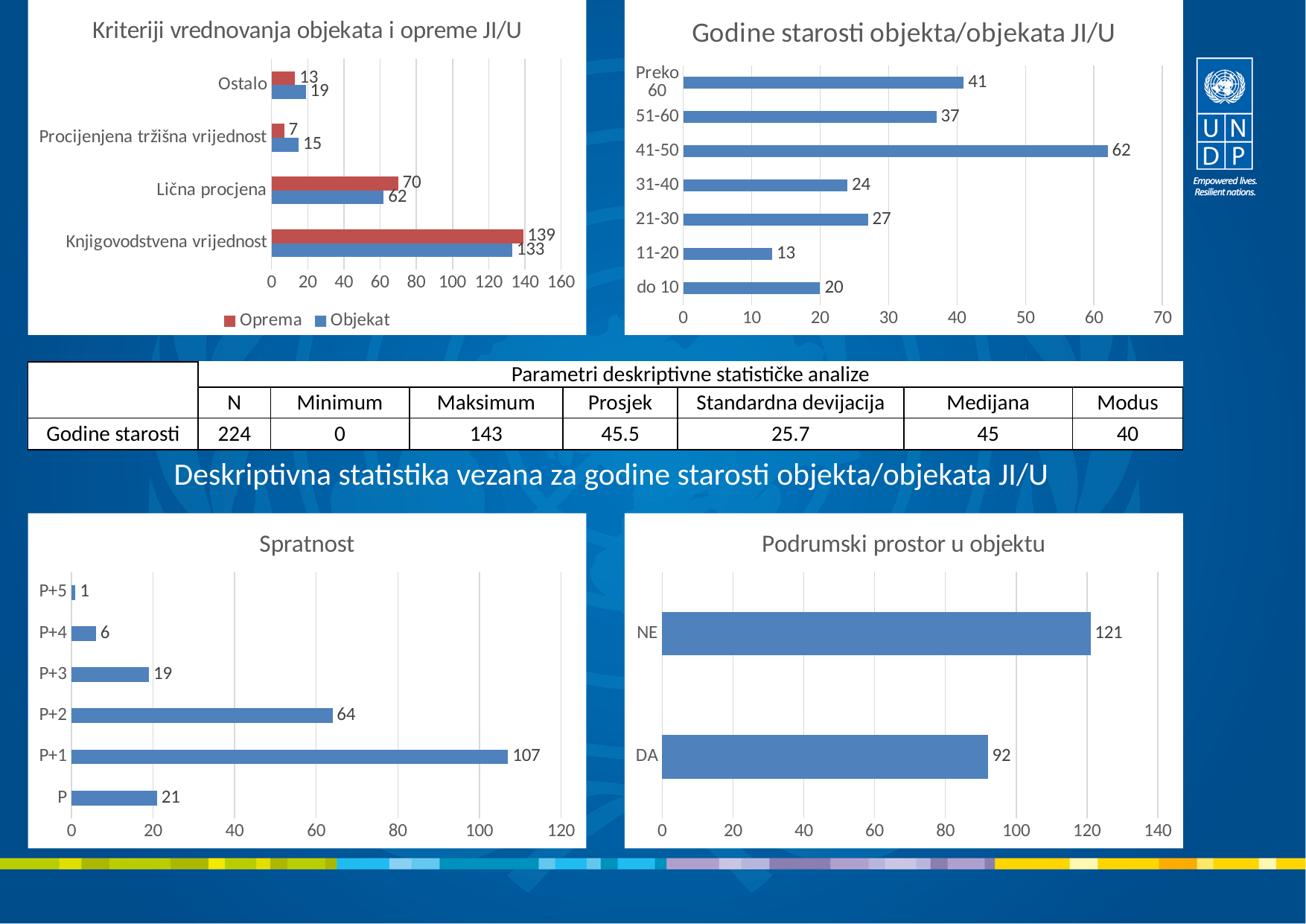
In the chart 'Podrumski prostor u objektu', what is the difference between NE and DA? 29 In the chart 'Godine starosti objekta/objekata JI/U', which age category has the highest value? 41-50 What kind of chart is 'Podrumski prostor u objektu'? Bar chart In the chart 'Kriteriji vrednovanja objekata i opreme JI/U', what is the difference between the Objekat and Oprema values for Ostalo? 6 In the chart 'Kriteriji vrednovanja objekata i opreme JI/U', what is the Oprema value for Knjigovodstvena vrijednost? 139 In the chart 'Kriteriji vrednovanja objekata i opreme JI/U', how many series does the legend list? 2 In the chart 'Spratnost', which category has the highest value? P+1 In the chart 'Spratnost', what is the value for P+2? 64 In the chart 'Godine starosti objekta/objekata JI/U', what is the value for 21-30? 27 In the chart 'Kriteriji vrednovanja objekata i opreme JI/U', what is the Objekat value for Lična procjena? 62 In the chart 'Godine starosti objekta/objekata JI/U', which age category has the lowest value? 11-20 In the chart 'Godine starosti objekta/objekata JI/U', how many age categories are shown? 7